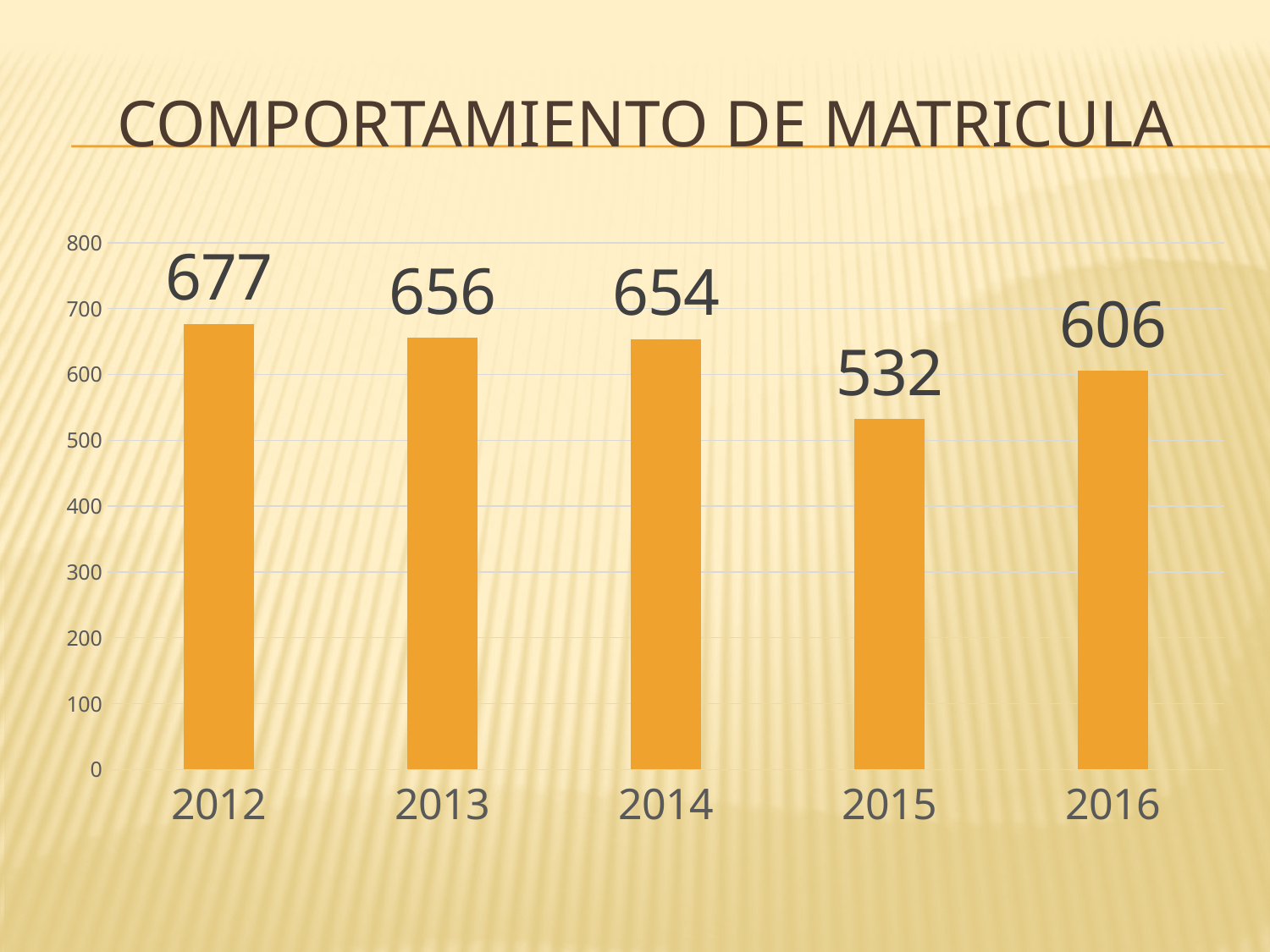
What kind of chart is shown on the slide? bar chart What is the value for 2015? 532 How many years are shown on the x axis? 5 What is the title of the chart? COMPORTAMIENTO DE MATRICULA What is the difference between the values for 2016 and 2015? 74 Which year has the highest value? 2012 What is the value for 2012? 677 What is the value for 2016? 606 Is the value for 2015 greater or less than 600? less Which year has the lowest value? 2015 What is the difference between the values for 2012 and 2015? 145 Which is larger, the value for 2013 or the value for 2016? 2013